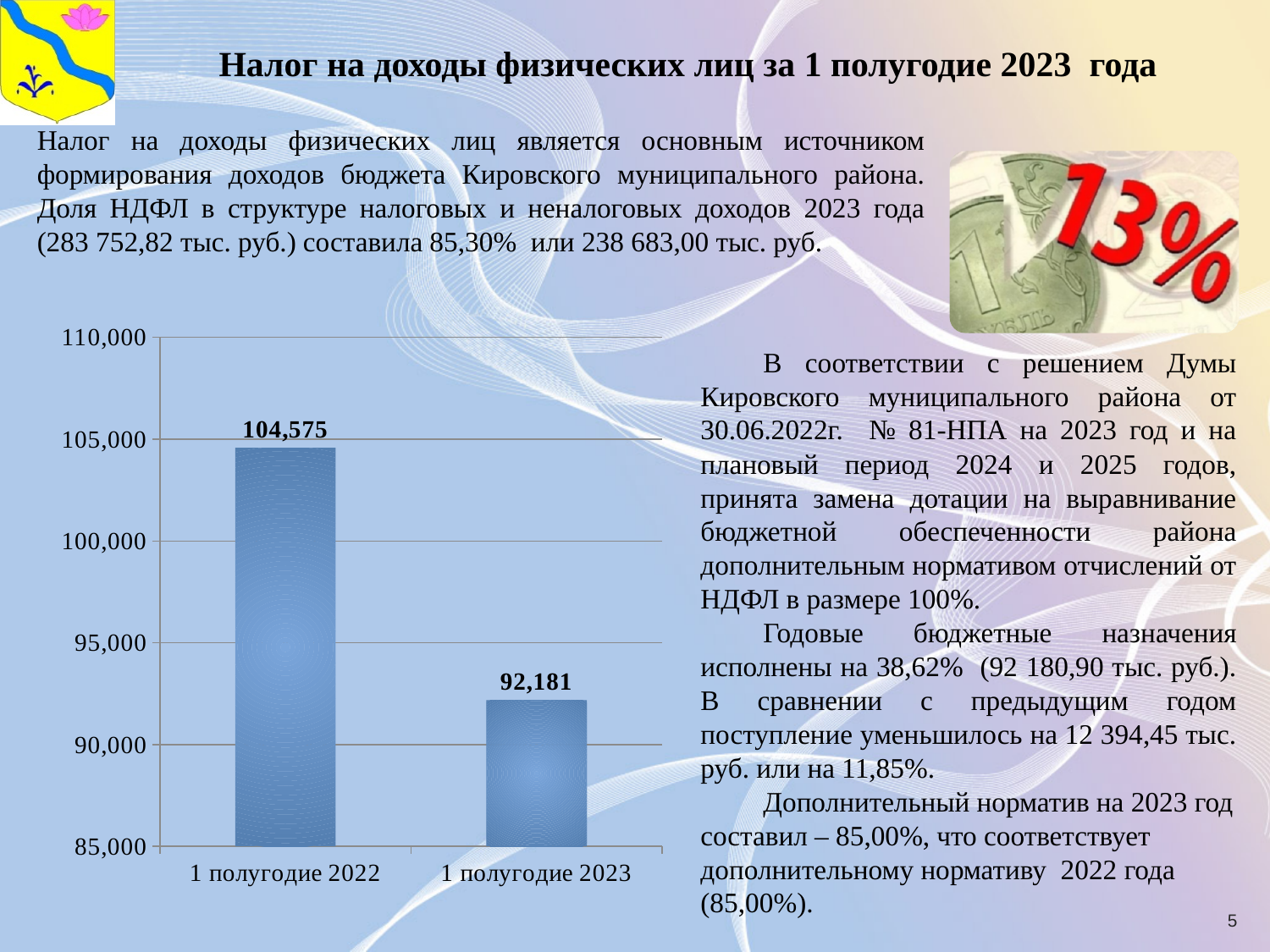
What kind of chart is shown on the slide? bar chart What is the lowest value shown on the chart's vertical axis? 85,000 What is the difference between the values for 1 полугодие 2022 and 1 полугодие 2023? 12,394 How many categories are shown on the chart? 2 Do the values rise or fall from 1 полугодие 2022 to 1 полугодие 2023? fall What is the value for 1 полугодие 2022? 104,575 Is the value for 1 полугодие 2022 greater or less than 100,000? greater Which is larger: the value for 1 полугодие 2022 or for 1 полугодие 2023? 1 полугодие 2022 Which category has the highest value? 1 полугодие 2022 What is the value for 1 полугодие 2023? 92,181 Is the value for 1 полугодие 2023 greater or less than 95,000? less Which category has the lowest value? 1 полугодие 2023